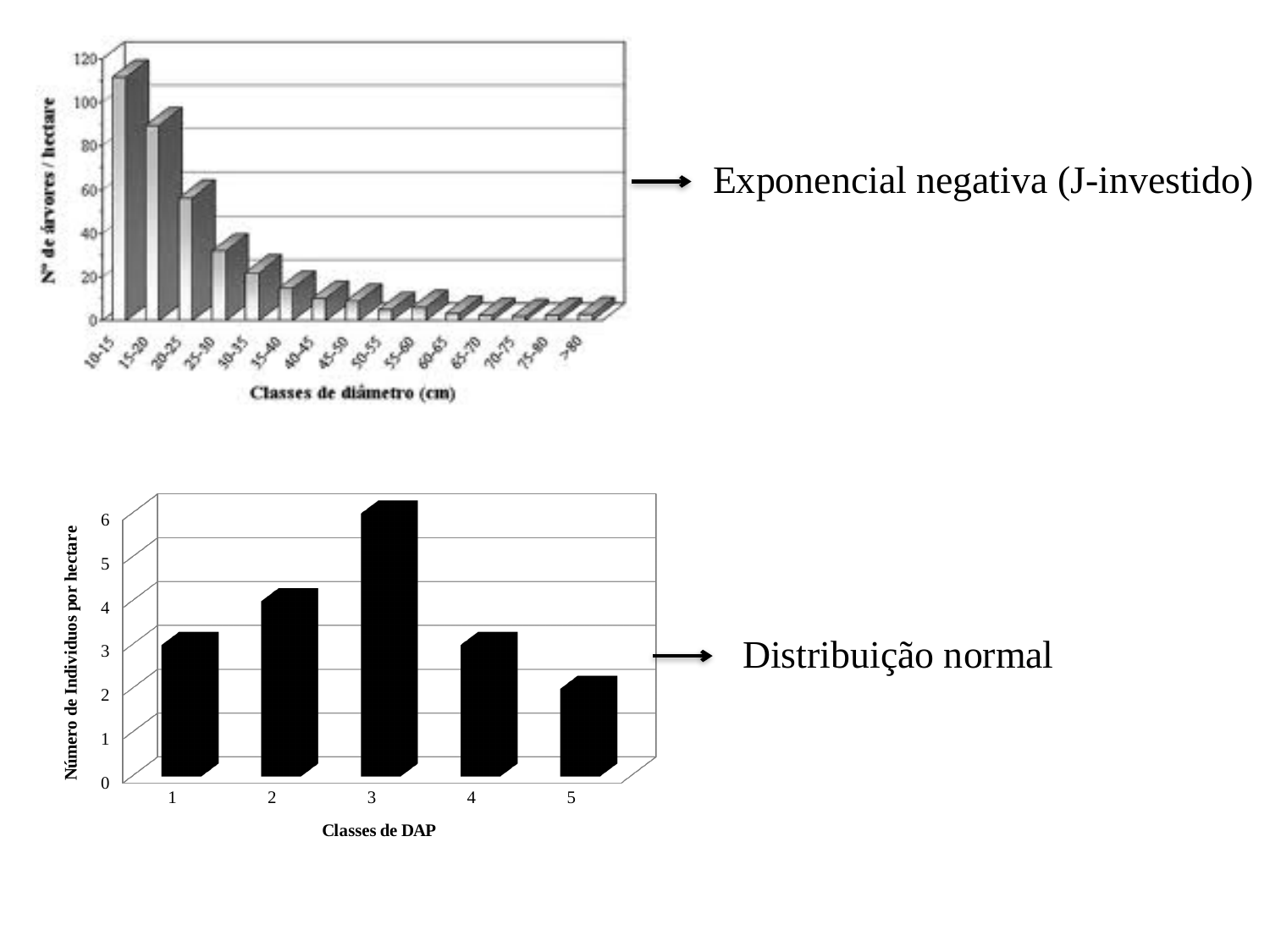
In the top chart (Classes de diâmetro), is the value for the 10-15 class greater or less than 100? greater In the top chart (Classes de diâmetro), how many diameter classes are shown on the x axis? 15 What kind of chart is the top chart (Classes de diâmetro)? bar chart In the bottom chart (Classes de DAP), how many DAP classes are shown? 5 In the bottom chart (Classes de DAP), which class has the highest number of individuals per hectare? 3 In the bottom chart (Classes de DAP), which class has the lowest number of individuals per hectare? 5 In the top chart (Classes de diâmetro), is the value for the 25-30 class greater or less than 40? less In the top chart (Classes de diâmetro), which diameter class has the highest number of trees per hectare? 10-15 In the top chart (Classes de diâmetro), which is larger, the value for 15-20 or the value for 20-25? 15-20 In the bottom chart (Classes de DAP), which is larger, the value for class 2 or the value for class 4? class 2 In the top chart (Classes de diâmetro), do the values rise or fall as the diameter class increases? fall What is the y-axis label of the bottom chart (Classes de DAP)? Número de Indivíduos por hectare